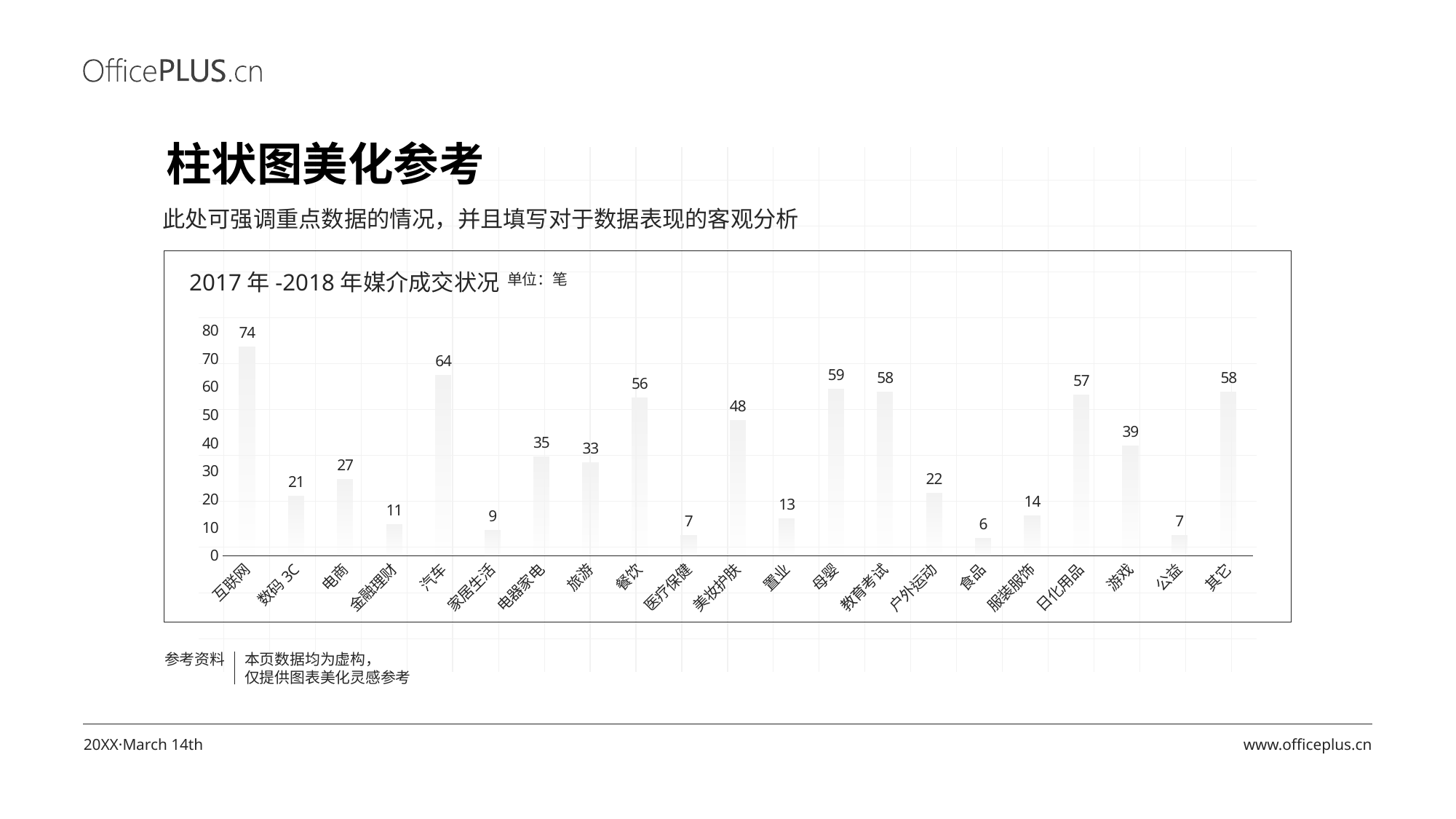
What kind of chart is shown on the slide? bar chart Which category has the lowest value? 食品 What is the difference between the values for 汽车 and 餐饮? 8 How many categories are shown on the x axis? 21 What is the difference between the values for 母婴 and 置业? 46 Which category has the highest value? 互联网 What is the value for 游戏? 39 What is the value for 美妆护肤? 48 What unit is stated next to the chart title? 笔 Is the value for 日化用品 greater or less than 50? greater Which is larger, the value for 电器家电 or the value for 旅游? 电器家电 What is the value for 互联网? 74